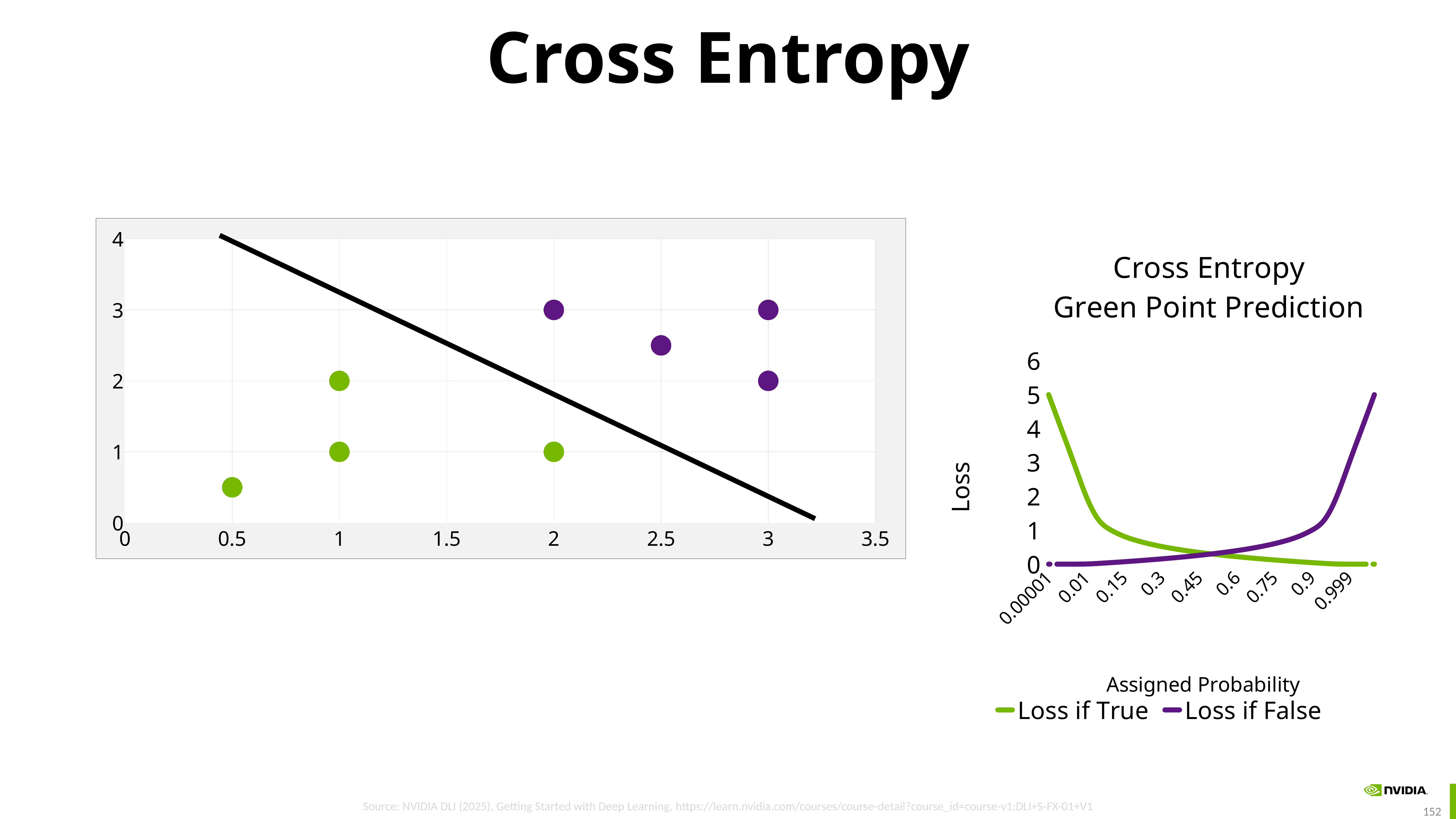
How many x-axis categories does the 'Cross Entropy Green Point Prediction' chart show? 9 In the 'Cross Entropy Green Point Prediction' chart, what is the label of the y axis? Loss How many series does the legend of the 'Cross Entropy Green Point Prediction' chart list? 2 In the 'Cross Entropy Green Point Prediction' chart, does the 'Loss if True' line rise or fall as the assigned probability increases? fall What kind of chart is the 'Cross Entropy Green Point Prediction' chart? line chart In the chart on the left, how many purple points are plotted? 4 In the 'Cross Entropy Green Point Prediction' chart, which series is larger at an assigned probability of 0.9, 'Loss if True' or 'Loss if False'? Loss if False In the 'Cross Entropy Green Point Prediction' chart, is the 'Loss if True' value at 0.00001 greater or less than 4? greater What kind of chart is the chart on the left of the slide? scatter chart In the chart on the left, what is the x value of the purple point at y = 2? 3 In the chart on the left, what is the y value of the green point at x = 2? 1 In the chart on the left, how many green points are plotted? 4